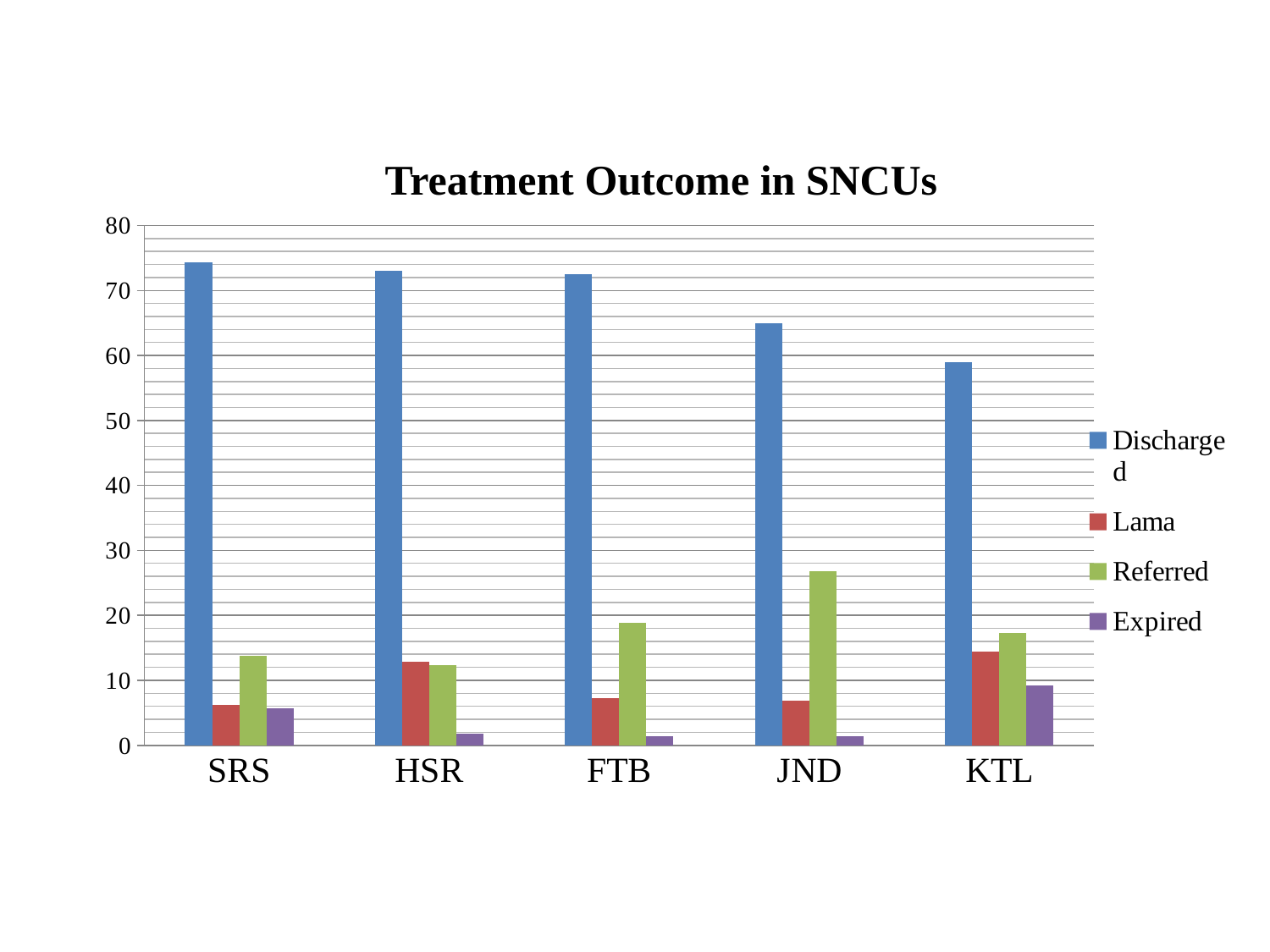
Is the Discharged value for SRS greater or less than 70? greater How many series does the legend list? 4 Is the Referred value for JND greater or less than 20? greater How many SNCU categories are shown on the x axis? 5 What type of chart is shown on the slide? bar chart Do the Discharged values rise or fall from SRS to KTL along the x axis? fall Which SNCU has the lowest Discharged value? KTL What is the title of the chart? Treatment Outcome in SNCUs Which is larger for FTB, the Referred value or the Lama value? Referred Which SNCU has the highest Expired value? KTL Which SNCU has the highest Referred value? JND